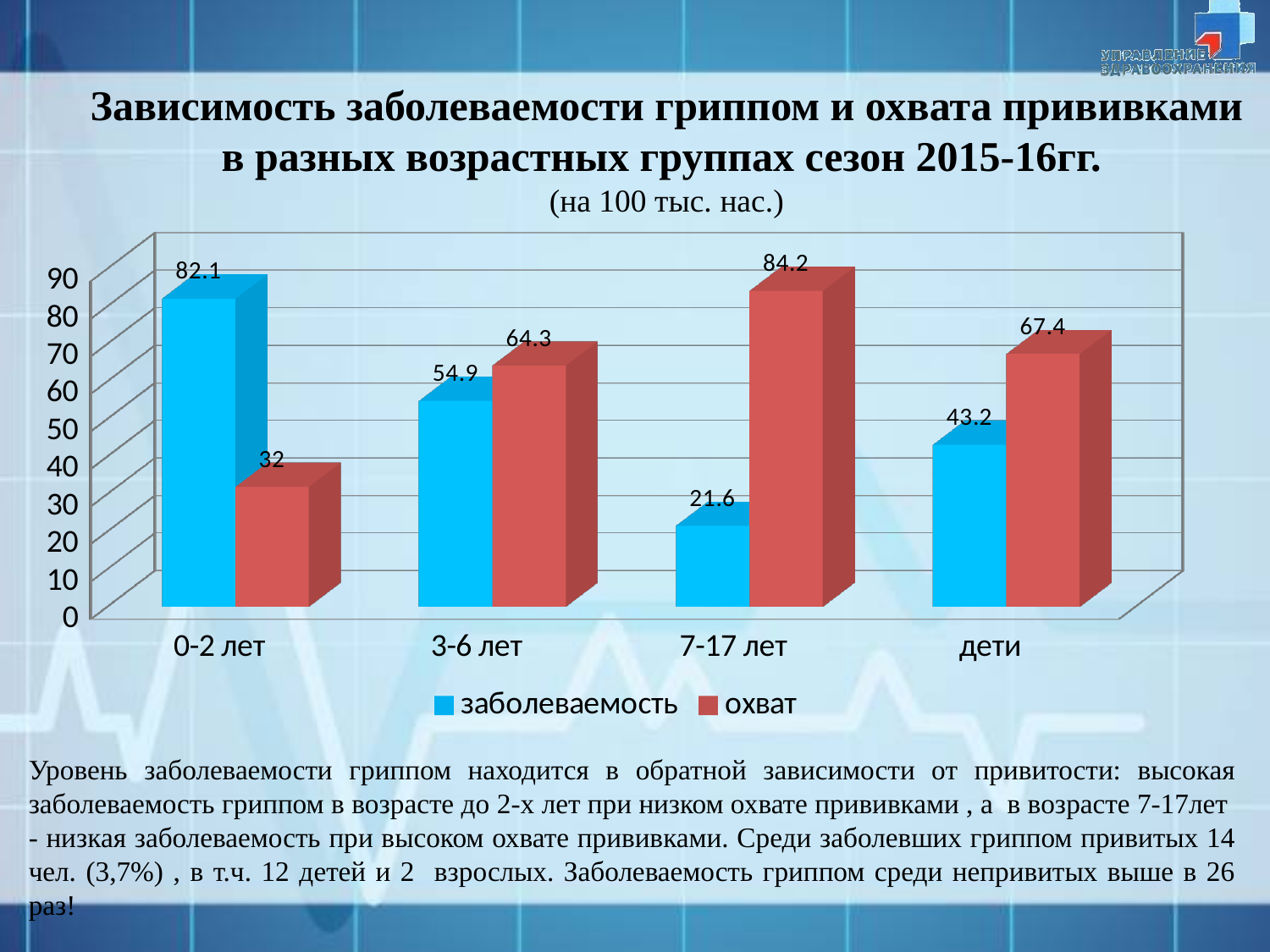
What is the value of охват for the 7-17 лет group? 84.2 What is the value of охват for the дети group? 67.4 How many age groups are shown on the x axis? 4 For the 3-6 лет group, which is larger: заболеваемость or охват? охват What kind of chart is shown on the slide? bar chart Which age group has the highest заболеваемость value? 0-2 лет How many series does the legend list? 2 Which colour represents the охват series? red What is the value of заболеваемость for the 0-2 лет group? 82.1 Is the заболеваемость value for the дети group greater or less than 50? less What is the difference between охват and заболеваемость for the 7-17 лет group? 62.6 Which age group has the lowest охват value? 0-2 лет